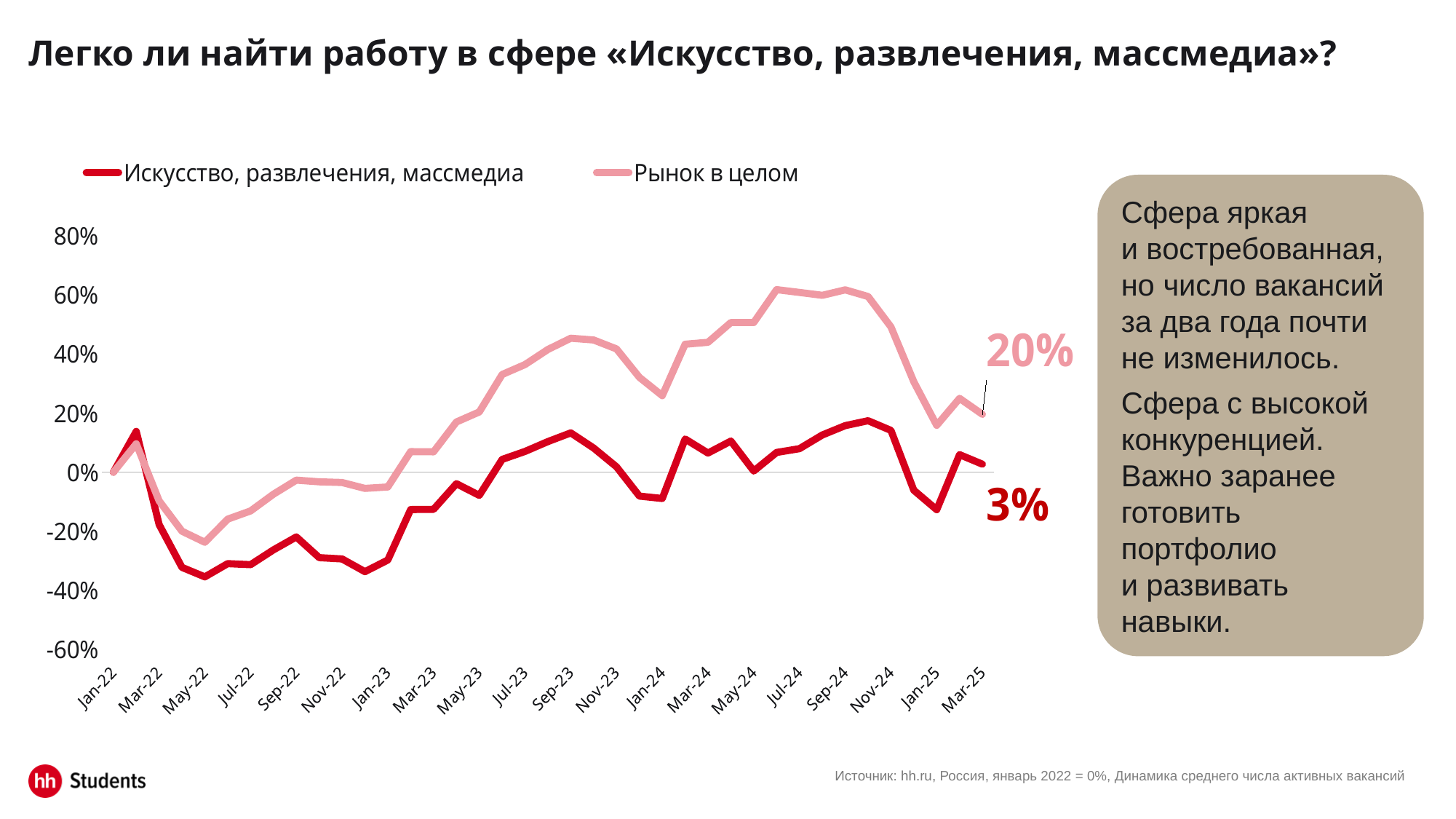
Is the value for «Рынок в целом» at Jul-24 greater or less than 40%? greater What is the value for «Искусство, развлечения, массмедиа» at Mar-25? 3% Does the «Рынок в целом» line rise or fall between Sep-24 and Jan-25? Falls At Mar-25, which series has the higher value: «Искусство, развлечения, массмедиа» or «Рынок в целом»? Рынок в целом What kind of chart is shown on the slide? Line chart Does the «Искусство, развлечения, массмедиа» line rise or fall between Jan-22 and May-22? Falls Is the value for «Искусство, развлечения, массмедиа» at May-22 greater or less than -20%? less Is the value for «Искусство, развлечения, массмедиа» at Sep-23 greater or less than 0%? greater What is the value for «Рынок в целом» at Mar-25? 20% What is the difference between the Mar-25 values of «Рынок в целом» and «Искусство, развлечения, массмедиа»? 17 percentage points Which colour is used for the «Рынок в целом» line? Light pink How many series does the legend list? 2